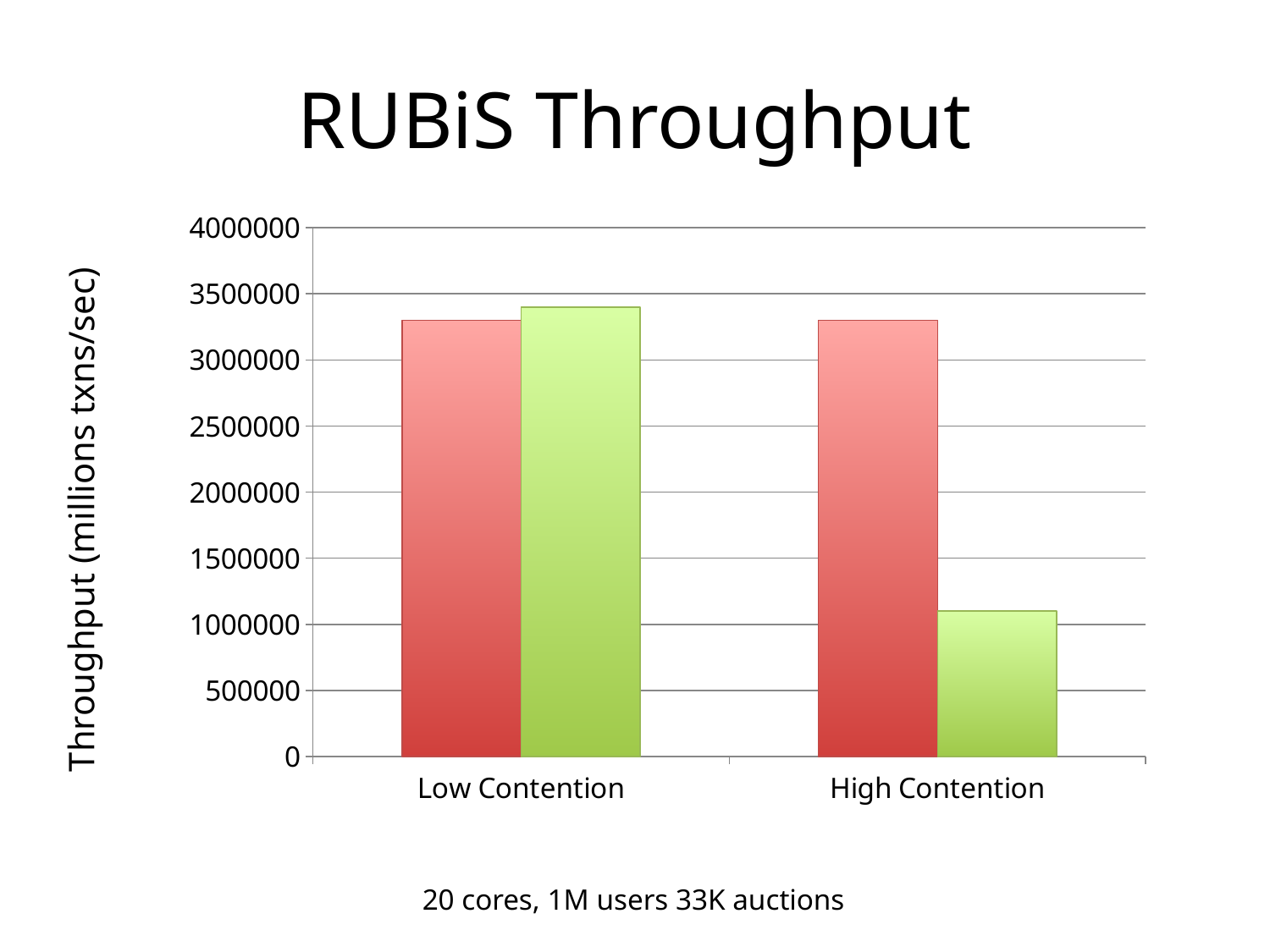
Is the value of the green bar for Low Contention greater or less than 3000000? greater For High Contention, which bar is larger, the red bar or the green bar? the red bar Which category has the larger green bar, Low Contention or High Contention? Low Contention Is the value of the red bar for High Contention greater or less than 3000000? greater Is the value of the green bar for High Contention greater or less than 1500000? less Which category has the lowest bar in the chart? High Contention How many categories are shown on the x axis of the chart? 2 What kind of chart is shown on the slide? bar chart What is the title of the chart? RUBiS Throughput What is the label on the vertical axis of the chart? Throughput (millions txns/sec)